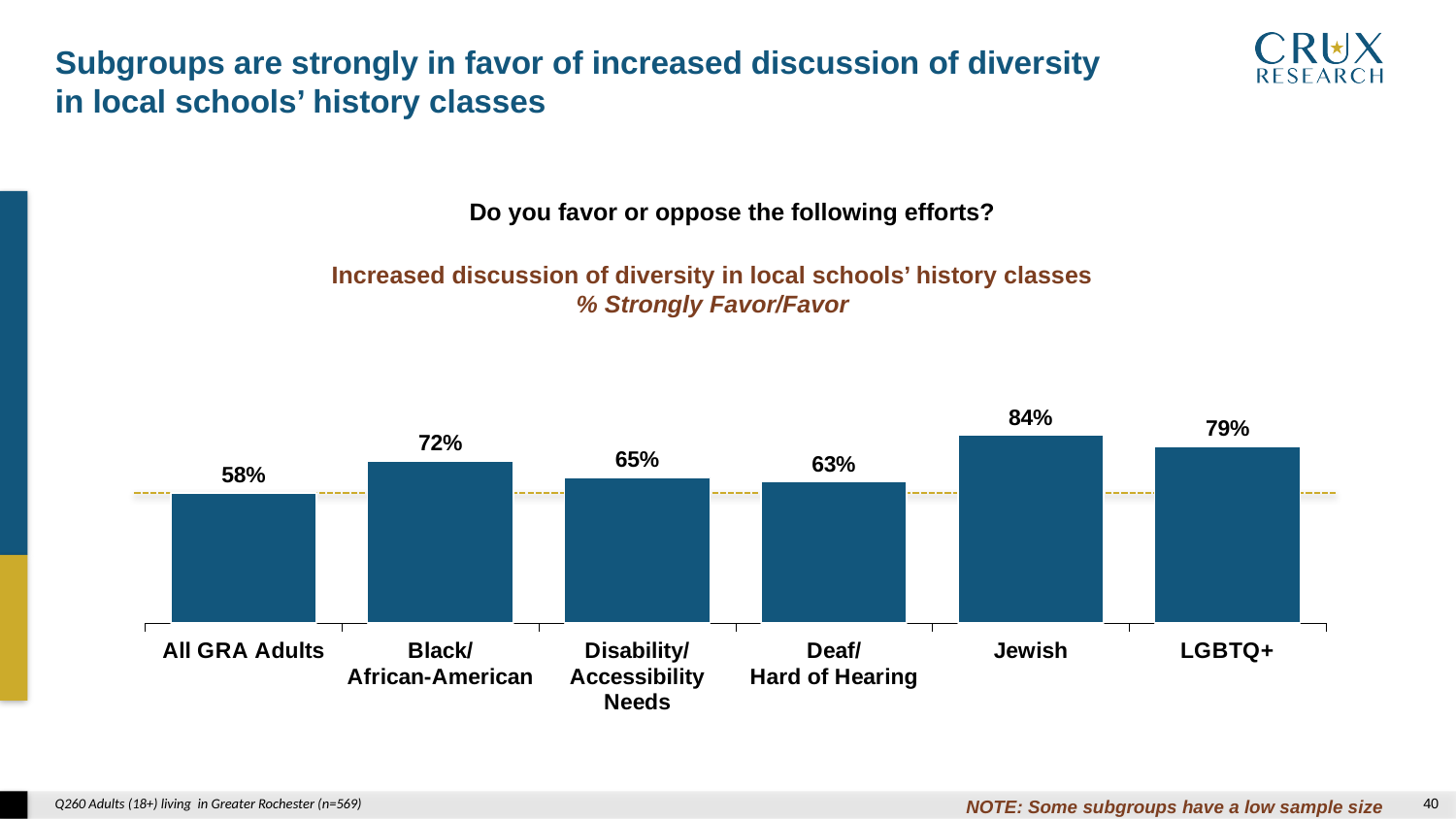
What is the difference between the LGBTQ+ and Black/African-American values? 7% What is the value shown for the Jewish subgroup? 84% What percentage of All GRA Adults strongly favor/favor increased discussion of diversity in local schools' history classes? 58% What measure does the chart subtitle say the bars represent? % Strongly Favor/Favor How many categories are shown on the chart? 6 What is the value shown for the LGBTQ+ subgroup? 79% What kind of chart is shown on the slide? Bar chart What is the difference between the Jewish and All GRA Adults values? 26% Which subgroup has the highest percentage strongly favoring/favoring the effort? Jewish What is the value shown for the Deaf/Hard of Hearing subgroup? 63% Which is larger, the value for Black/African-American or the value for Disability/Accessibility Needs? Black/African-American Which category has the lowest value on the chart? All GRA Adults